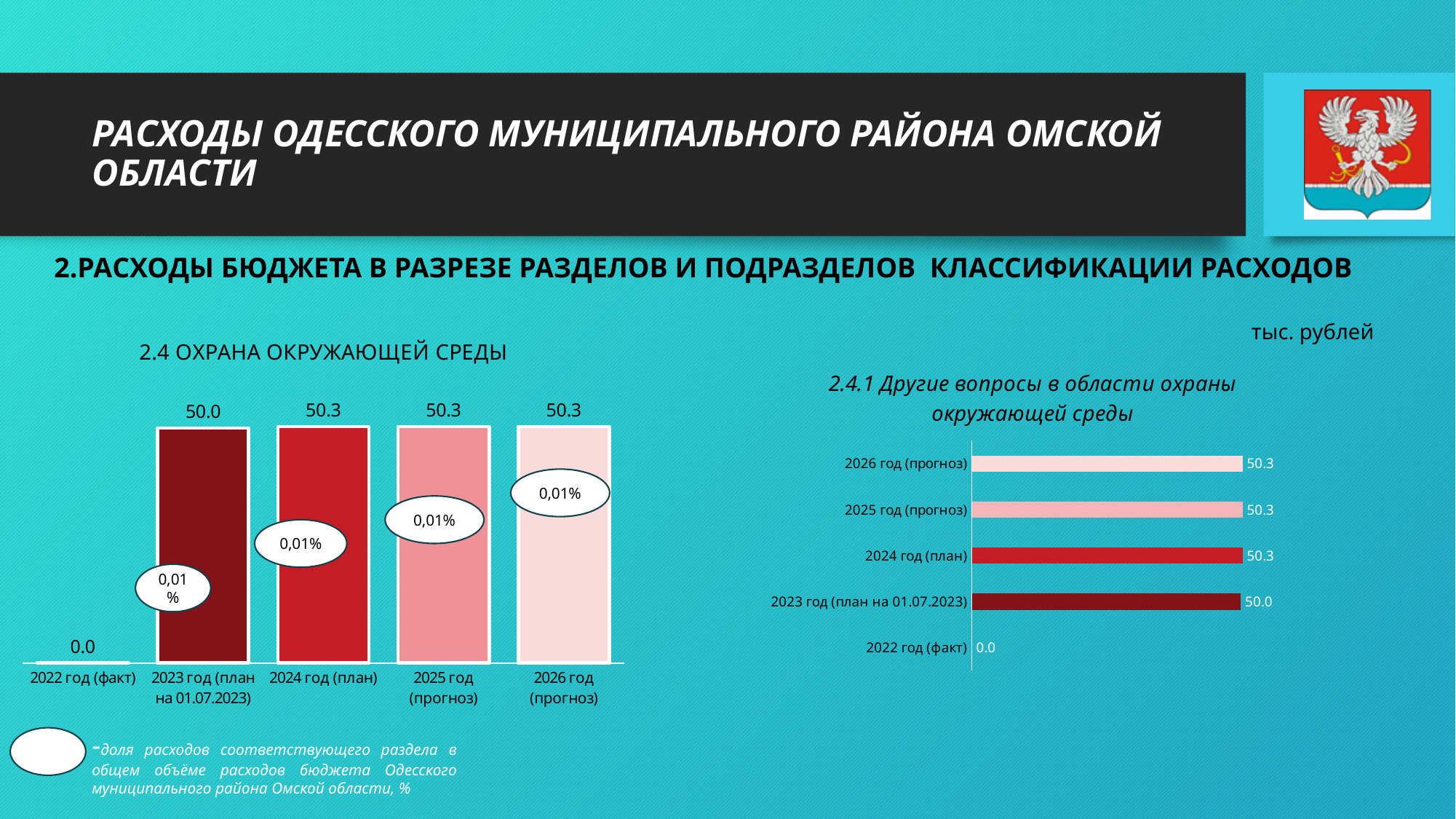
In the chart titled "2.4 ОХРАНА ОКРУЖАЮЩЕЙ СРЕДЫ", what is the difference between the values for 2024 год (план) and 2023 год (план на 01.07.2023)? 0.3 In the chart titled "2.4 ОХРАНА ОКРУЖАЮЩЕЙ СРЕДЫ", what is the value for 2026 год (прогноз)? 50.3 What unit of measurement is indicated for the charts on the slide? тыс. рублей In the chart titled "2.4 ОХРАНА ОКРУЖАЮЩЕЙ СРЕДЫ", what is the value for 2023 год (план на 01.07.2023)? 50.0 In the chart titled "2.4 ОХРАНА ОКРУЖАЮЩЕЙ СРЕДЫ", how many categories are shown on the x axis? 5 What type of chart is the one titled "2.4.1 Другие вопросы в области охраны окружающей среды"? bar chart In the chart titled "2.4.1 Другие вопросы в области охраны окружающей среды", which is larger: the value for 2023 год (план на 01.07.2023) or the value for 2022 год (факт)? 2023 год (план на 01.07.2023) In the chart titled "2.4 ОХРАНА ОКРУЖАЮЩЕЙ СРЕДЫ", which category has the lowest value? 2022 год (факт) In the chart titled "2.4.1 Другие вопросы в области охраны окружающей среды", what is the value for 2024 год (план)? 50.3 In the chart titled "2.4.1 Другие вопросы в области охраны окружающей среды", how many bars are shown? 4 In the chart titled "2.4 ОХРАНА ОКРУЖАЮЩЕЙ СРЕДЫ", what share of total budget expenditure is shown in the oval for 2025 год (прогноз)? 0,01% In the chart titled "2.4 ОХРАНА ОКРУЖАЮЩЕЙ СРЕДЫ", what is the value for 2022 год (факт)? 0.0